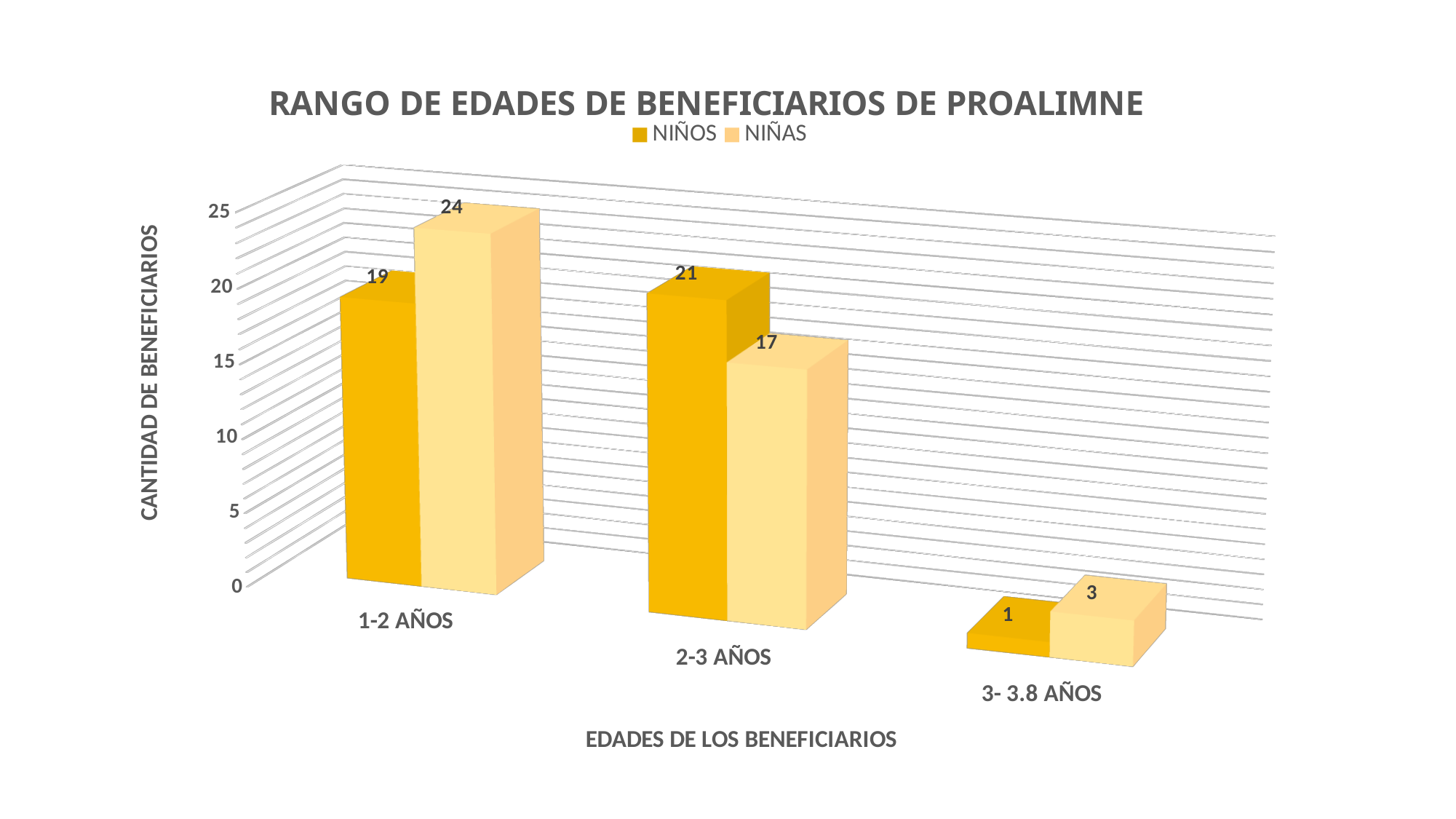
What kind of chart is shown on the slide? Bar chart How many series does the legend list? 2 What is the value for NIÑOS in the 2-3 AÑOS category? 21 How many age categories are shown on the x axis? 3 Which age category has the highest value for NIÑAS? 1-2 AÑOS What is the value for NIÑOS in the 1-2 AÑOS category? 19 In the 2-3 AÑOS category, which is larger, NIÑOS or NIÑAS? NIÑOS What is the value for NIÑAS in the 3- 3.8 AÑOS category? 3 What is the value for NIÑAS in the 1-2 AÑOS category? 24 What is the title of the chart? RANGO DE EDADES DE BENEFICIARIOS DE PROALIMNE What is the difference between NIÑAS and NIÑOS in the 1-2 AÑOS category? 5 Which age category has the lowest value for NIÑOS? 3- 3.8 AÑOS